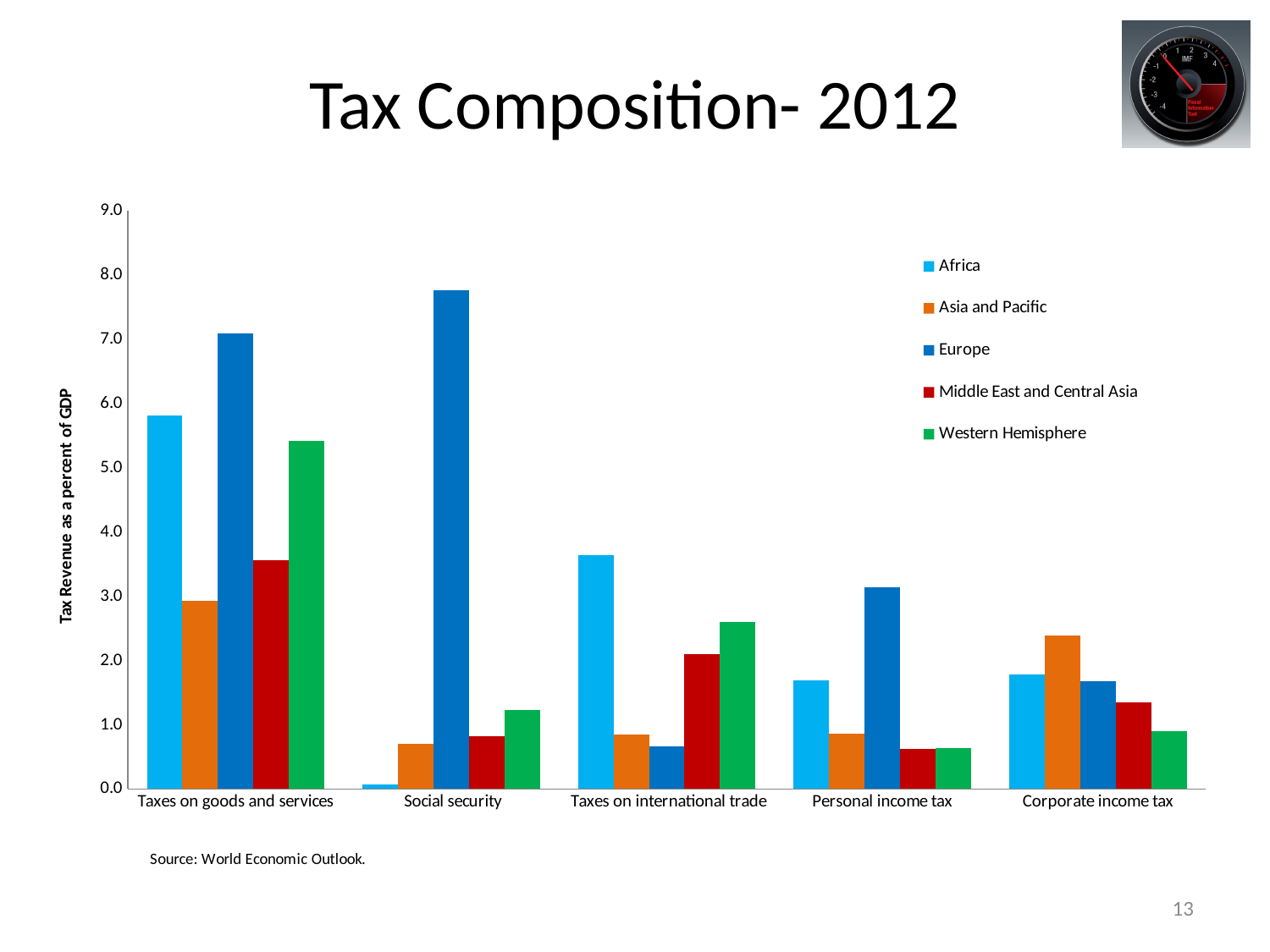
Which region has the highest value for Social security? Europe Is the value for Africa in Taxes on goods and services greater or less than 6.0? less What kind of chart is shown on the slide? Bar chart Which region has the highest value for Taxes on international trade? Africa For Corporate income tax, which is larger: Asia and Pacific or Africa? Asia and Pacific How many tax categories are shown along the x axis? 5 How many series does the legend list? 5 What is the title of the y axis? Tax Revenue as a percent of GDP Which region has the lowest value for Social security? Africa Is the value for Europe in Social security greater or less than 7.0? greater Which region has the highest value for Taxes on goods and services? Europe What source is cited below the chart? World Economic Outlook